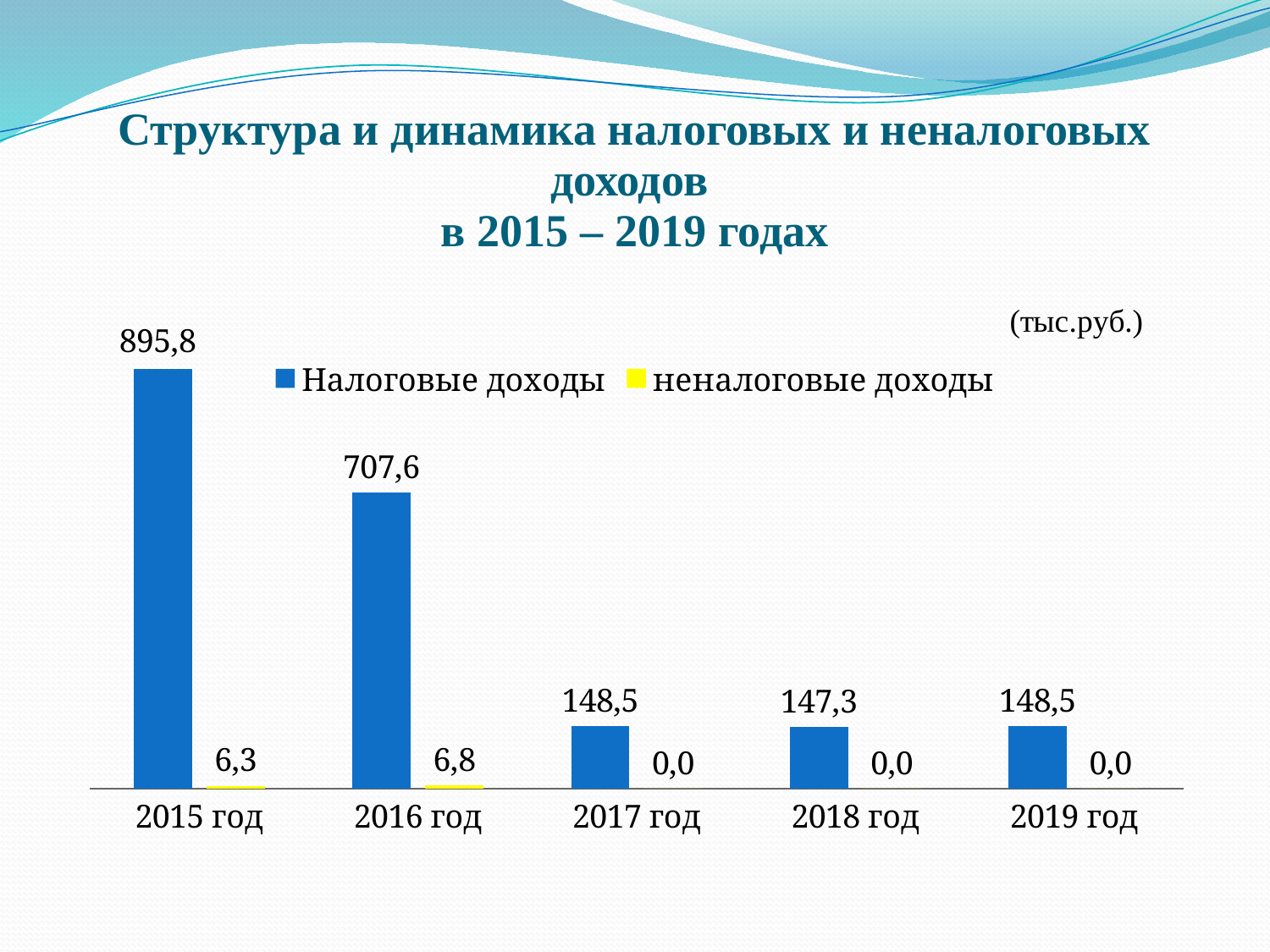
What unit is indicated for the values on the chart? тыс.руб. Which year has the lowest value of Налоговые доходы? 2018 год What is the value of неналоговые доходы for 2016 год? 6,8 What is the value of Налоговые доходы for 2018 год? 147,3 What is the value of неналоговые доходы for 2019 год? 0,0 Which year has the highest value of Налоговые доходы? 2015 год What is the difference between Налоговые доходы in 2015 год and 2016 год? 188,2 How many years are shown on the x axis? 5 Which is larger: неналоговые доходы in 2015 год or in 2016 год? 2016 год What is the value of Налоговые доходы for 2015 год? 895,8 What kind of chart is shown on the slide? Bar chart How many series does the legend list? 2